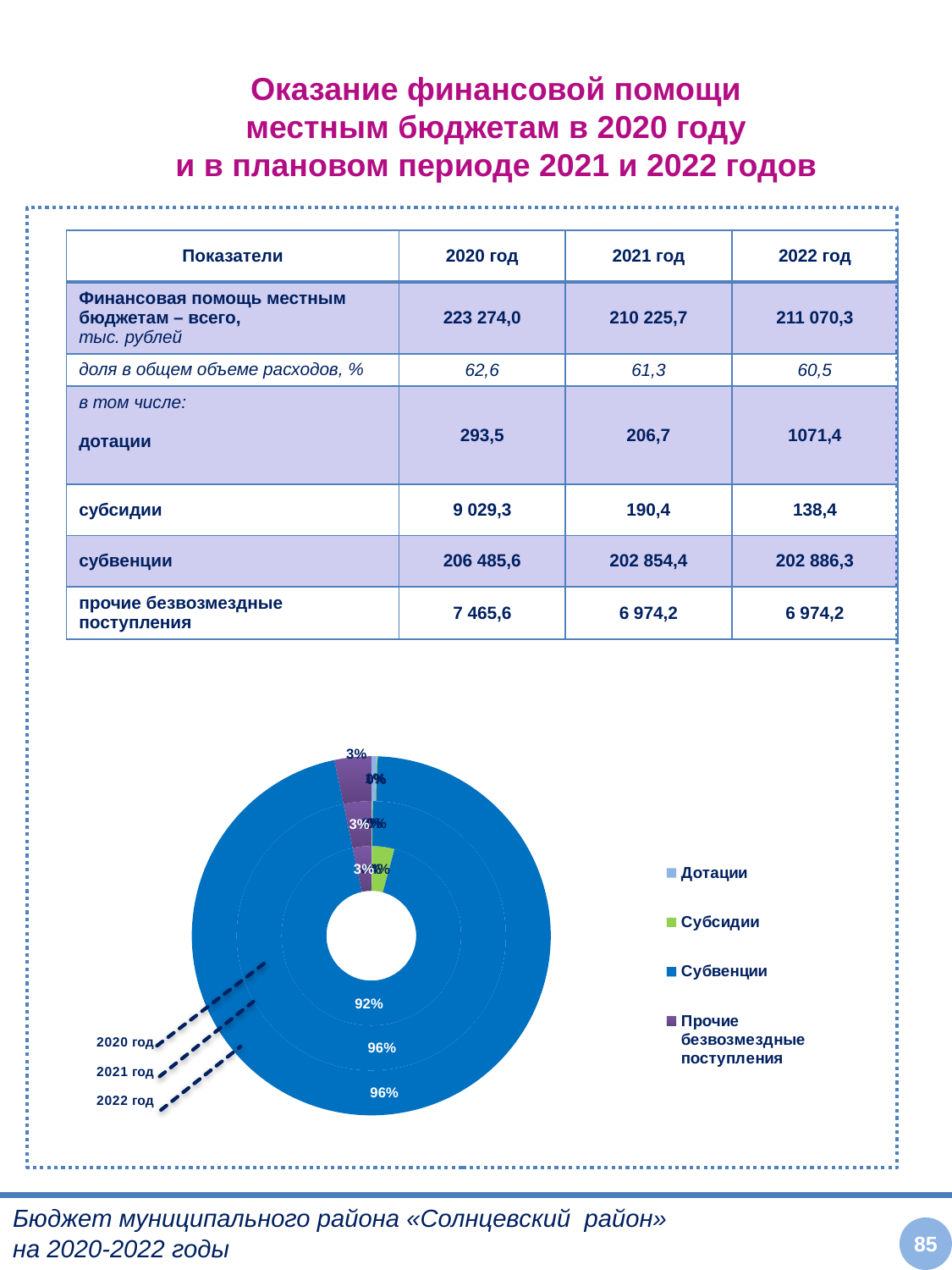
What share of the 2020 ring is Субвенции? 92% Which year is represented by the innermost ring of the chart? 2020 год What share of the 2022 ring is Субвенции? 96% What kind of chart is shown on the slide? Doughnut (pie) chart By how many percentage points does the Субвенции share in 2021 exceed that in 2020? 4% Is the share of Субвенции larger in 2020 or in 2021? 2021 What share of the 2020 ring is Прочие безвозмездные поступления? 3% Which legend entry is shown in green? Субсидии Which category has the largest share in every ring of the chart? Субвенции How many series does the chart legend list? 4 How many rings (years) does the doughnut chart show? 3